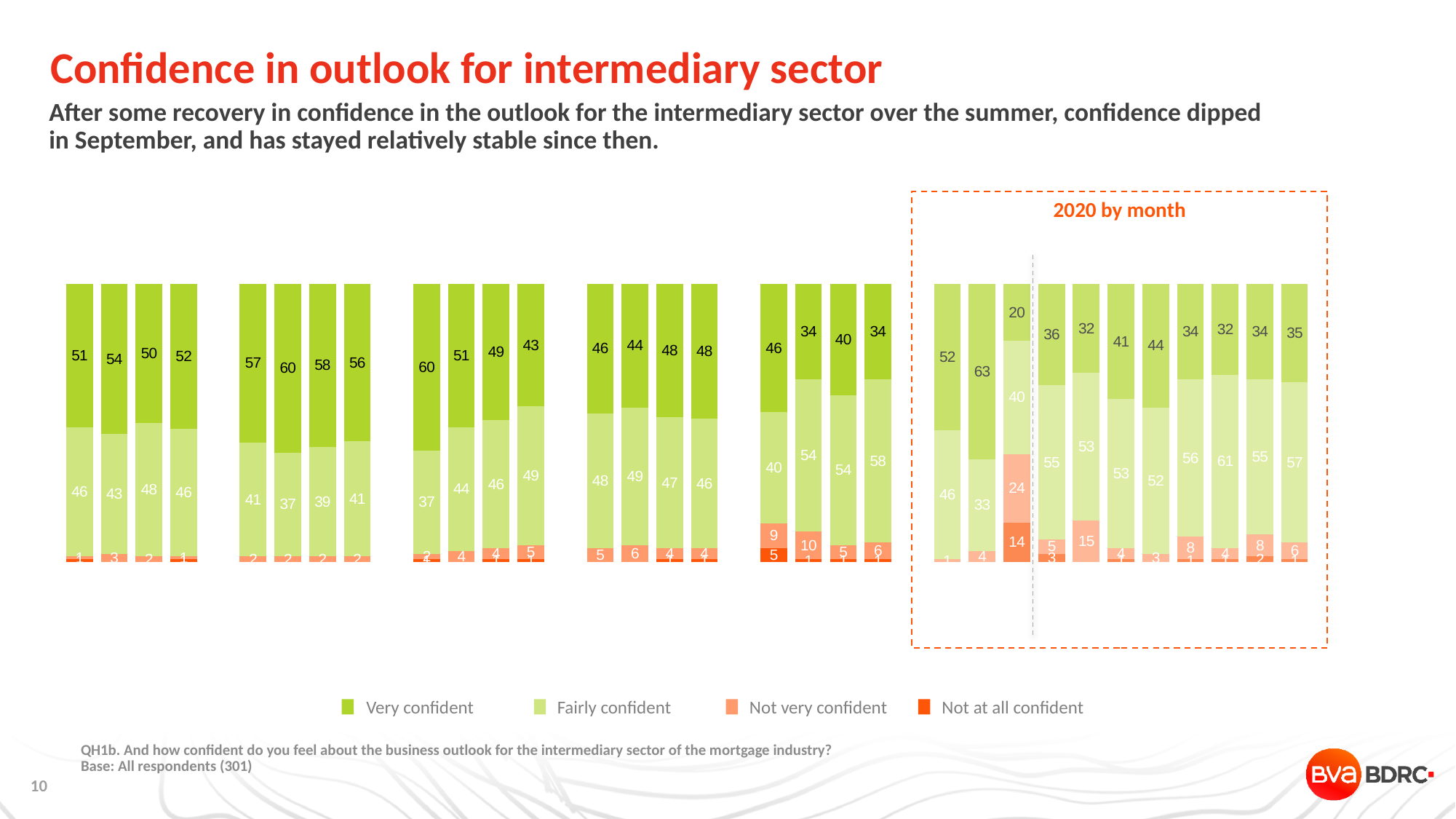
In the '2020 by month' section, what is the Fairly confident value for the second bar? 33 How many series does the legend list? 4 What are the four legend entries of the chart? Very confident, Fairly confident, Not very confident, Not at all confident In the '2020 by month' section, which has the larger Very confident value: the first bar or the second bar? The second bar How many bars are inside the '2020 by month' dashed box? 11 What kind of chart is shown on the slide? Stacked bar chart What label appears on the dashed box around the right-hand group of bars? 2020 by month What is the highest Not very confident value shown on the chart? 24 For the rightmost bar on the chart, what is the difference between the Fairly confident value (57) and the Very confident value (35)? 22 Across all bars on the chart, which bar has the lowest Very confident value, and what is it? The third bar in the '2020 by month' section, 20 In the '2020 by month' section, what is the difference between the Very confident values of the second bar (63) and the first bar (52)? 11 In the '2020 by month' section, what is the Very confident value for the first (leftmost) bar? 52